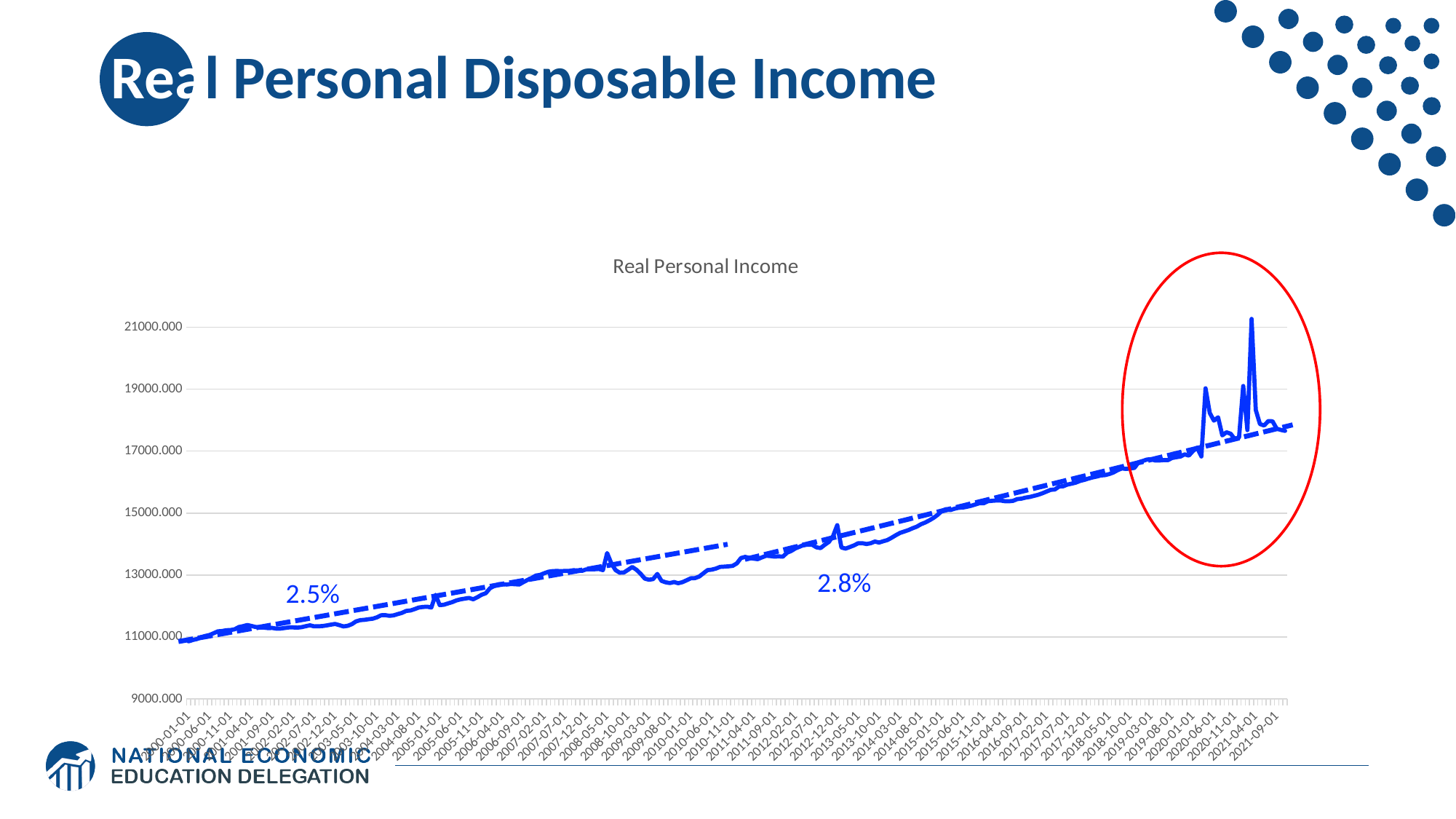
What is the title of the chart? Real Personal Income Is the value around 2018-01-01 greater or less than 17000.000? less What kind of chart is shown on the slide? line chart What growth rate is annotated on the right-hand dashed trend line? 2.8% Is the highest peak of the line greater or less than 19000.000? greater Is the value at the end of the series (2021-09-01) greater or less than 17000.000? greater What growth rate is annotated on the left-hand dashed trend line? 2.5% Overall, does real personal income rise or fall from 2000 to 2021 along the x axis? rise In which year does the line reach its highest value? 2021